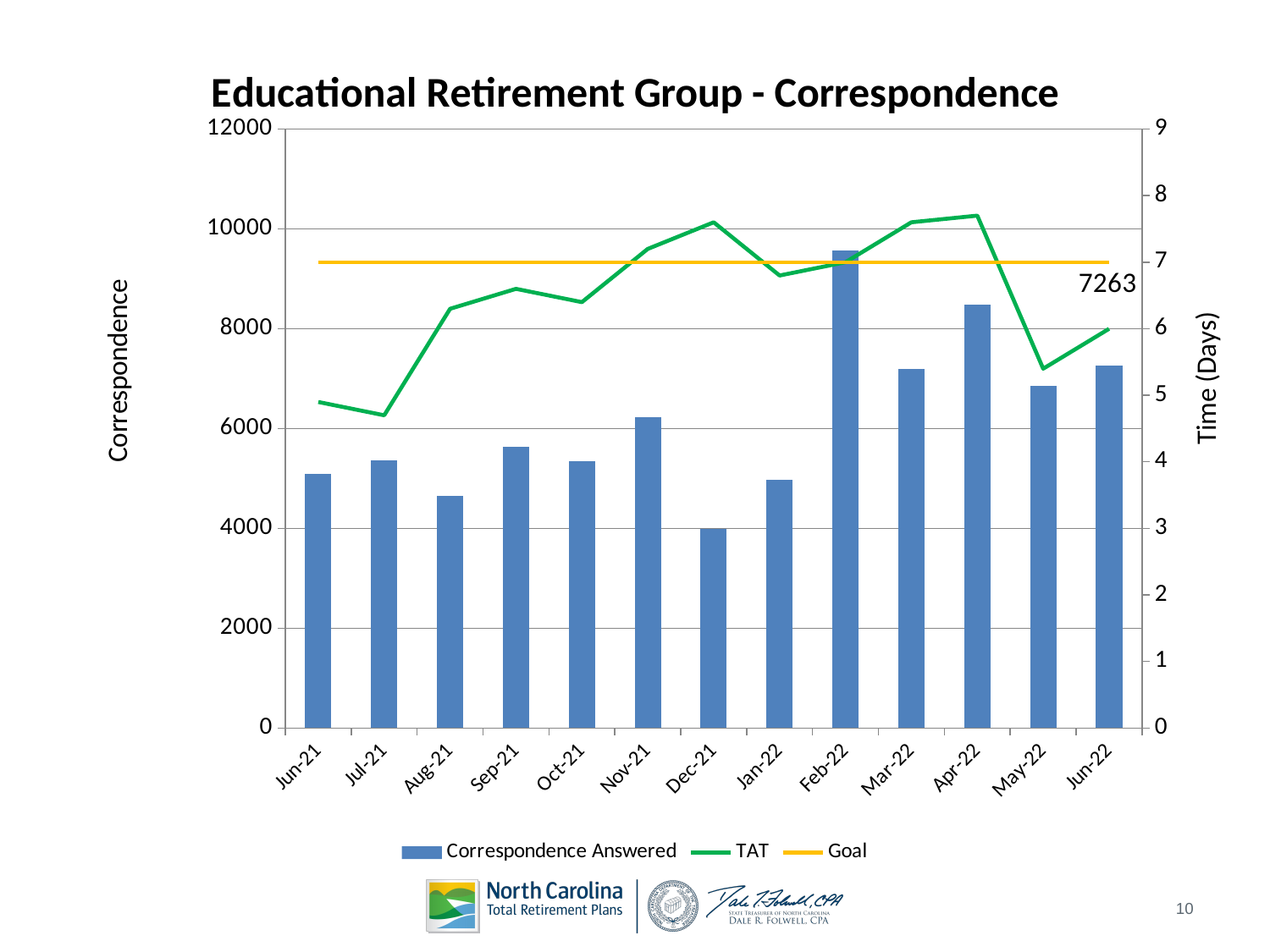
Is the Correspondence Answered value for Dec-21 greater or less than 6000? less Which month has more Correspondence Answered, Nov-21 or Jan-22? Nov-21 What kind of chart is shown on the slide? Bar and line chart What is the Goal value in days on the right axis? 7 Which month has more Correspondence Answered, Apr-22 or May-22? Apr-22 Is the Correspondence Answered value for Mar-22 greater or less than 6000? greater Is the Correspondence Answered value for Feb-22 greater or less than 8000? greater Which month has the lowest Correspondence Answered bar? Dec-21 How many series does the legend list? 3 How many months are shown on the x axis? 13 Which month has the highest Correspondence Answered bar? Feb-22 What is the value of Correspondence Answered for Jun-22? 7263